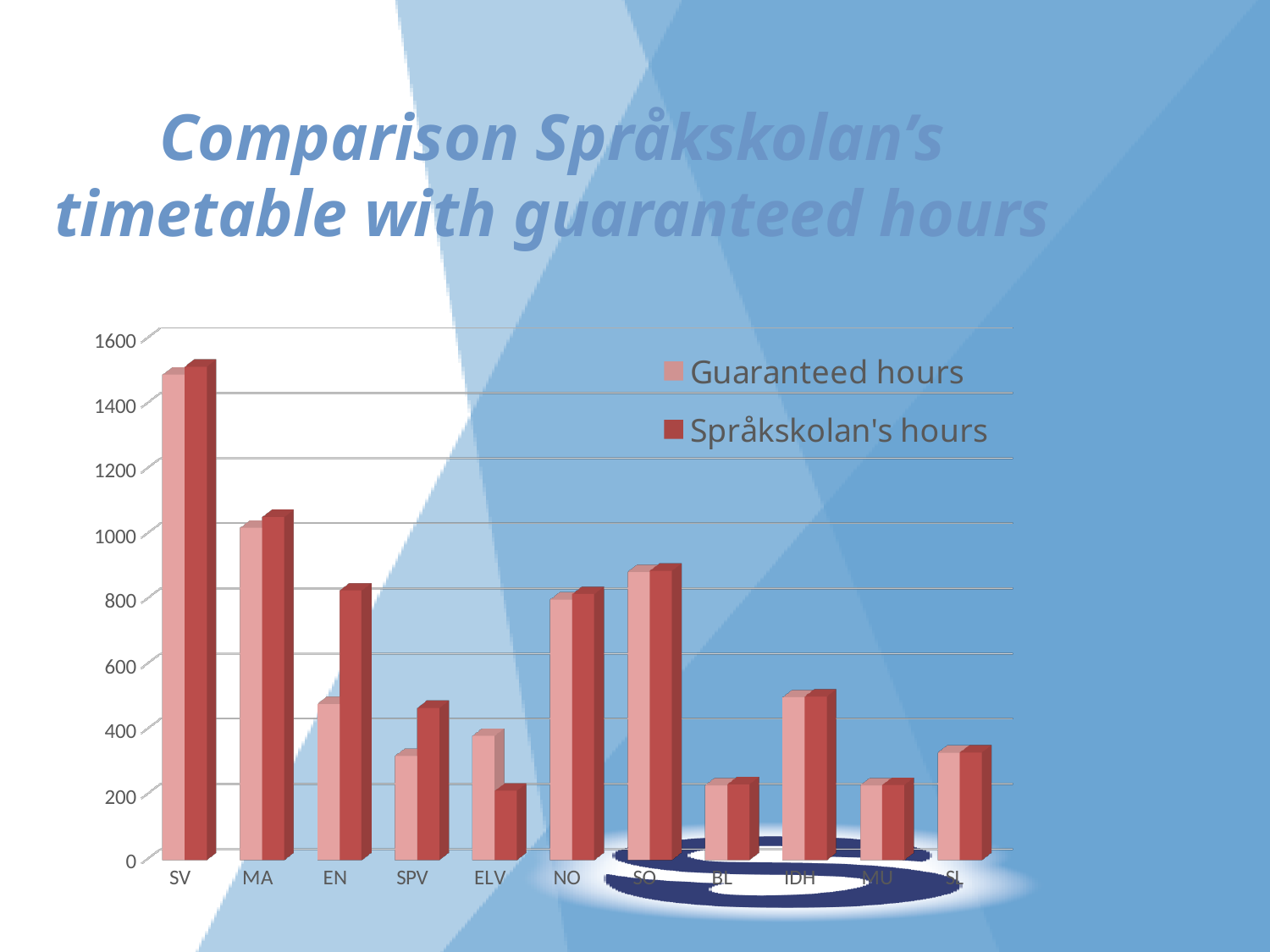
Is the Guaranteed hours value for SPV greater or less than 400? less Which colour represents Språkskolan's hours in the legend? Dark red Is the Guaranteed hours value for SV greater or less than 1400? greater Which category has the highest value for Språkskolan's hours? SV For ELV, which is larger: Guaranteed hours or Språkskolan's hours? Guaranteed hours What kind of chart is shown on the slide? Bar chart Is the Språkskolan's hours value for ELV greater or less than 400? less How many series does the legend list? 2 For EN, which is larger: Guaranteed hours or Språkskolan's hours? Språkskolan's hours Which category has the highest value for Guaranteed hours? SV How many categories are shown on the x axis? 11